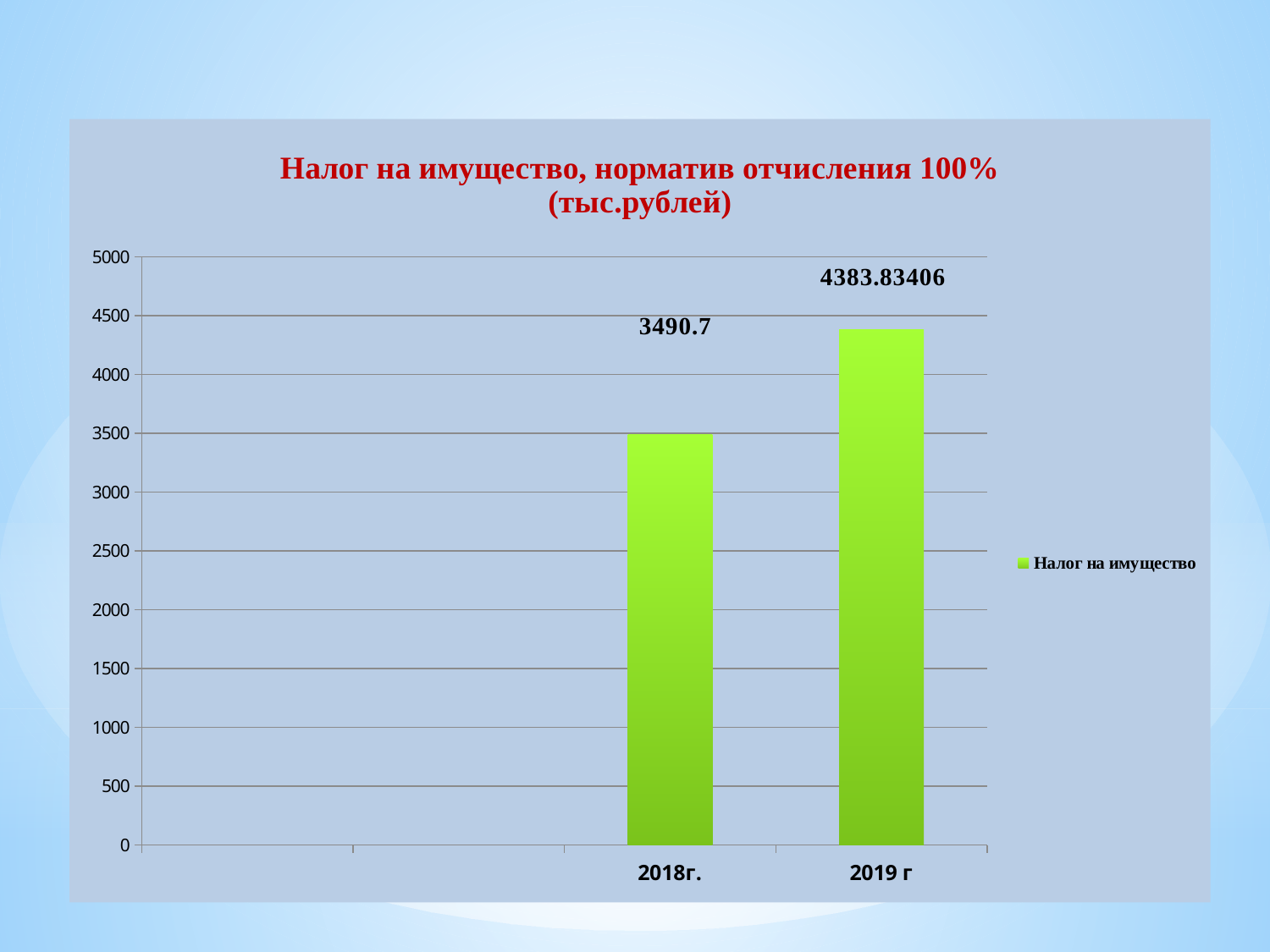
Is the value for 2019 г greater or less than 4500? less What is the value for 2019 г? 4383.83406 What is the value for 2018г.? 3490.7 Which year has the lowest value? 2018г. Which year has the highest value? 2019 г What is the title of the chart? Налог на имущество, норматив отчисления 100% (тыс.рублей) Which is larger, the value for 2018г. or the value for 2019 г? 2019 г Is the value for 2018г. greater or less than 3000? greater What kind of chart is shown on the slide? Bar chart How many bars are plotted on the chart? 2 What is the difference between the values for 2019 г and 2018г.? 893.13406 How many series does the legend list? 1